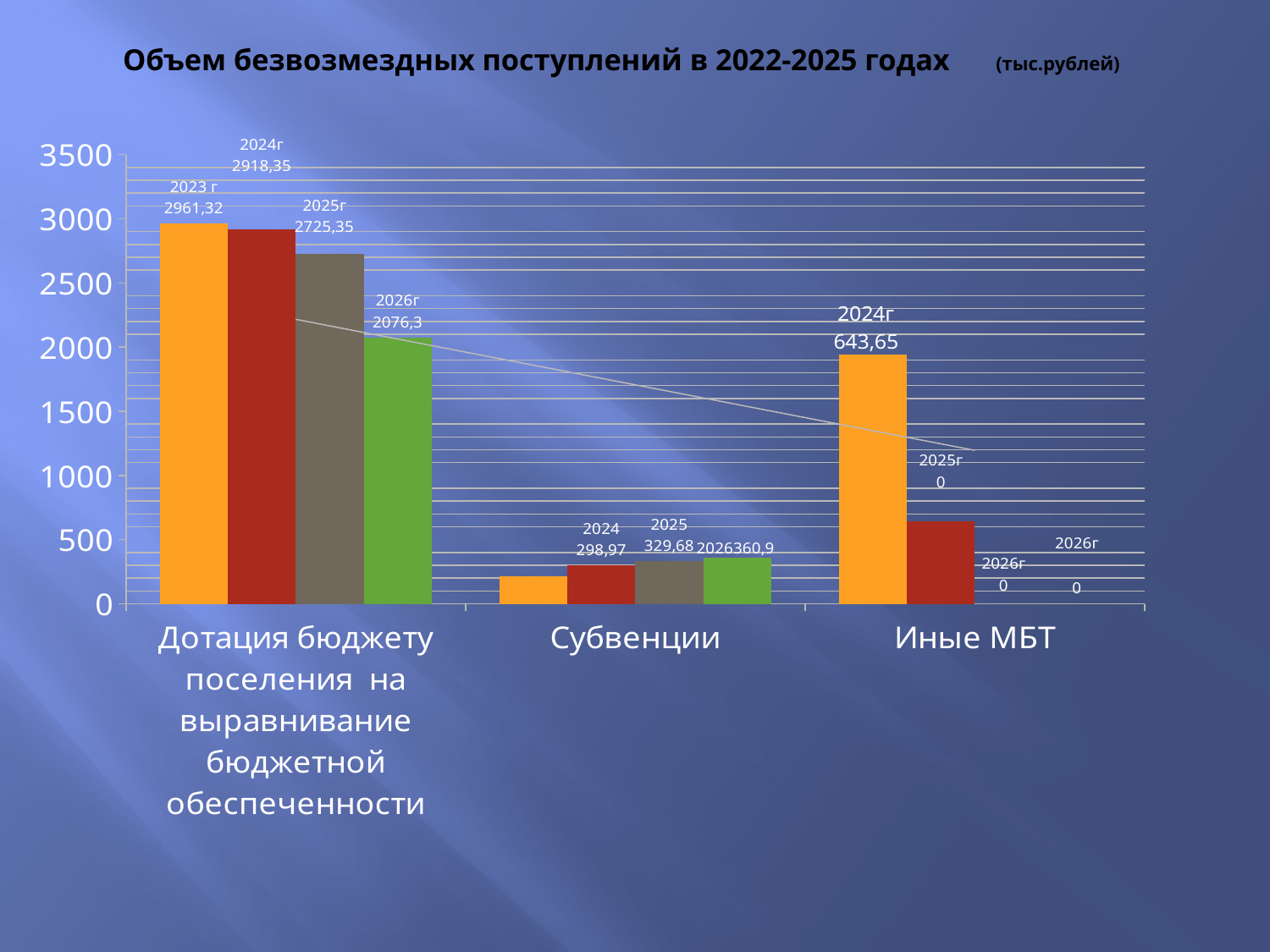
What is the value for 2025 for Субвенции? 329,68 What kind of chart is shown on the slide? bar chart Do the values for Дотация бюджету поселения на выравнивание бюджетной обеспеченности rise or fall from 2023 г to 2026г? fall What is the value for 2023 г for Дотация бюджету поселения на выравнивание бюджетной обеспеченности? 2961,32 How many categories are shown on the x axis? 3 What is the difference between the 2026 and 2024 values for Субвенции? 61,93 Is the 2025г value for Дотация бюджету поселения на выравнивание бюджетной обеспеченности greater or less than 2500? greater Do the values for Субвенции rise or fall from 2024 to 2026? rise What is the value for 2026г for Дотация бюджету поселения на выравнивание бюджетной обеспеченности? 2076,3 What is the difference between the 2023 г and 2026г values for Дотация бюджету поселения на выравнивание бюджетной обеспеченности? 885,02 What is the value for 2026 for Субвенции? 360,9 For Дотация бюджету поселения на выравнивание бюджетной обеспеченности, which is larger: the 2024г value or the 2025г value? 2024г